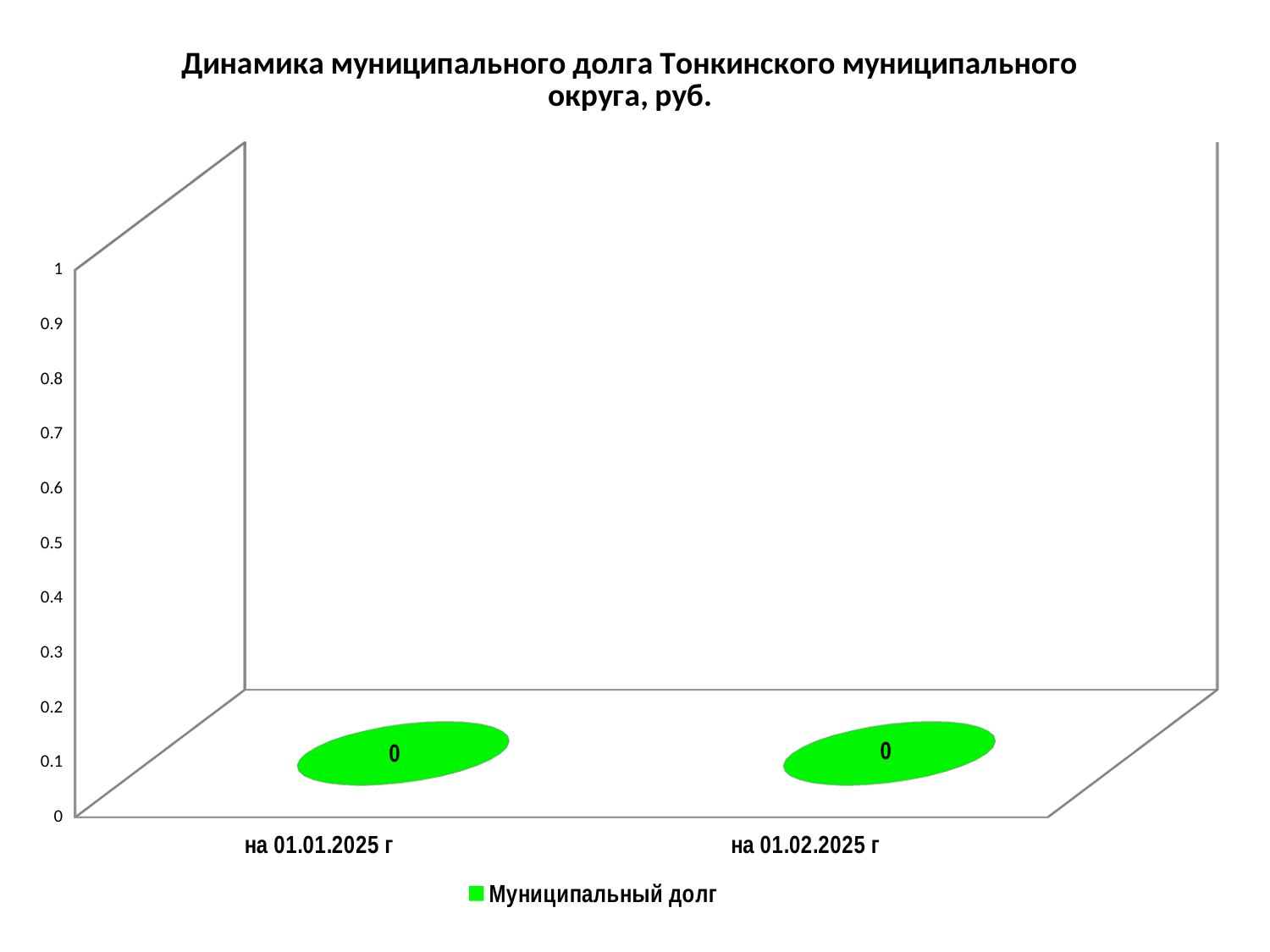
What is the highest value shown on the vertical axis? 1 Do the values rise, fall or stay the same from "на 01.01.2025 г" to "на 01.02.2025 г"? stay the same Is the value for "на 01.02.2025 г" greater or less than 0.1? less What is the value for "на 01.01.2025 г"? 0 What is the value for "на 01.02.2025 г"? 0 What series name is shown in the legend? Муниципальный долг What is the difference between the values for "на 01.01.2025 г" and "на 01.02.2025 г"? 0 Is the value for "на 01.01.2025 г" greater or less than 0.5? less How many categories are shown on the x axis? 2 How many series does the legend list? 1 What is the title of the chart? Динамика муниципального долга Тонкинского муниципального округа, руб. What kind of chart is shown on the slide? bar chart